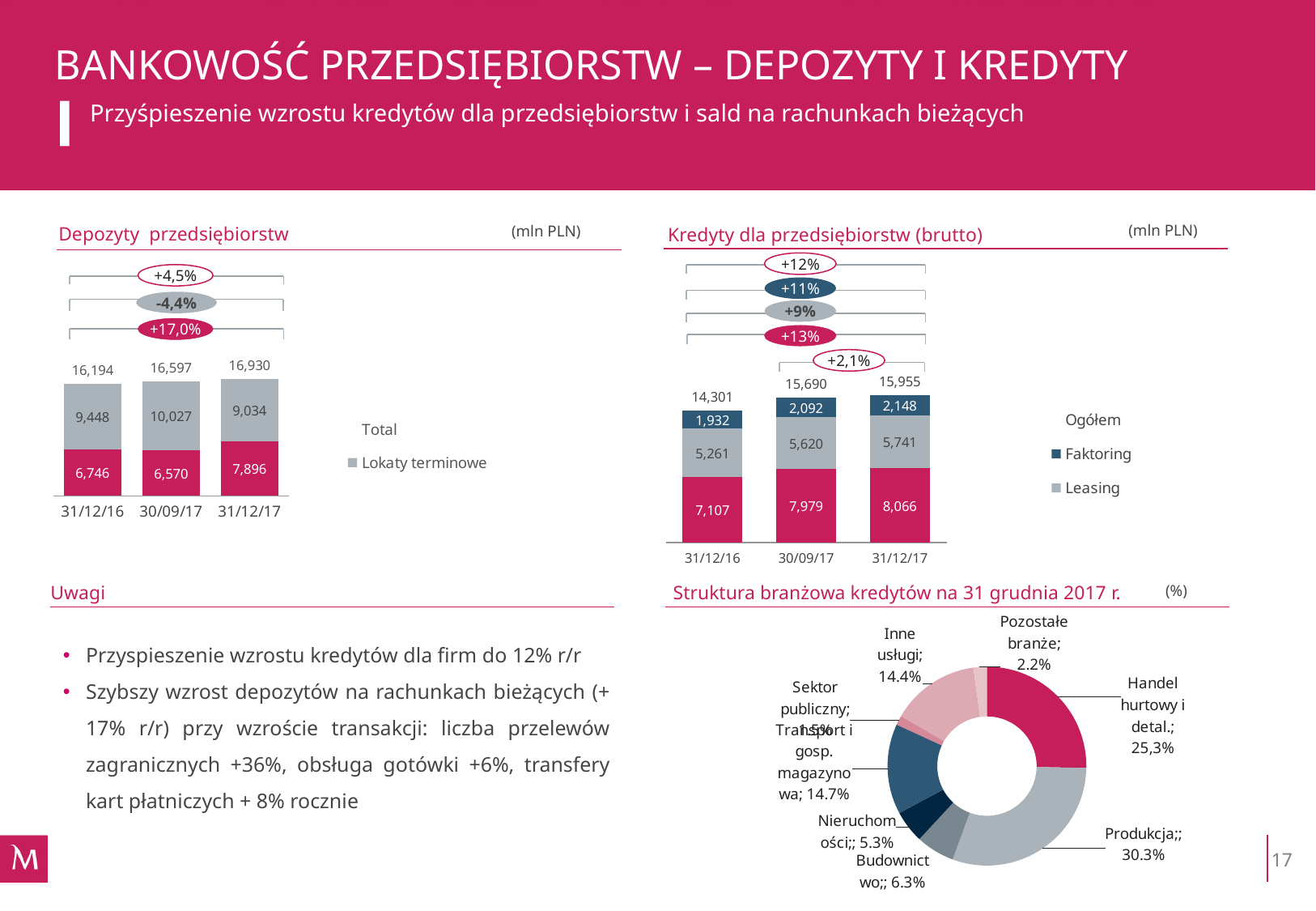
In the 'Kredyty dla przedsiębiorstw (brutto)' chart, which date has the highest total (Ogółem)? 31/12/17 What kind of chart is 'Struktura branżowa kredytów na 31 grudnia 2017 r.'? Donut (pie) chart In the 'Kredyty dla przedsiębiorstw (brutto)' chart, what is the Faktoring value for 31/12/17? 2,148 In the 'Struktura branżowa kredytów na 31 grudnia 2017 r.' chart, what share does Produkcja have? 30.3% In the 'Kredyty dla przedsiębiorstw (brutto)' chart, how many entries does the legend list? 3 In the 'Struktura branżowa kredytów na 31 grudnia 2017 r.' chart, which sector has the largest share? Produkcja In the 'Depozyty przedsiębiorstw' chart, which date has the lowest value of Lokaty terminowe? 31/12/17 In the 'Depozyty przedsiębiorstw' chart, what is the difference between the total for 31/12/17 and the total for 31/12/16? 736 In the 'Kredyty dla przedsiębiorstw (brutto)' chart, how many dates are shown on the x axis? 3 In the 'Depozyty przedsiębiorstw' chart, what is the value of Lokaty terminowe for 30/09/17? 10,027 In the 'Depozyty przedsiębiorstw' chart, what is the total value for 31/12/17? 16,930 In the 'Kredyty dla przedsiębiorstw (brutto)' chart, what is the Leasing value for 31/12/16? 5,261